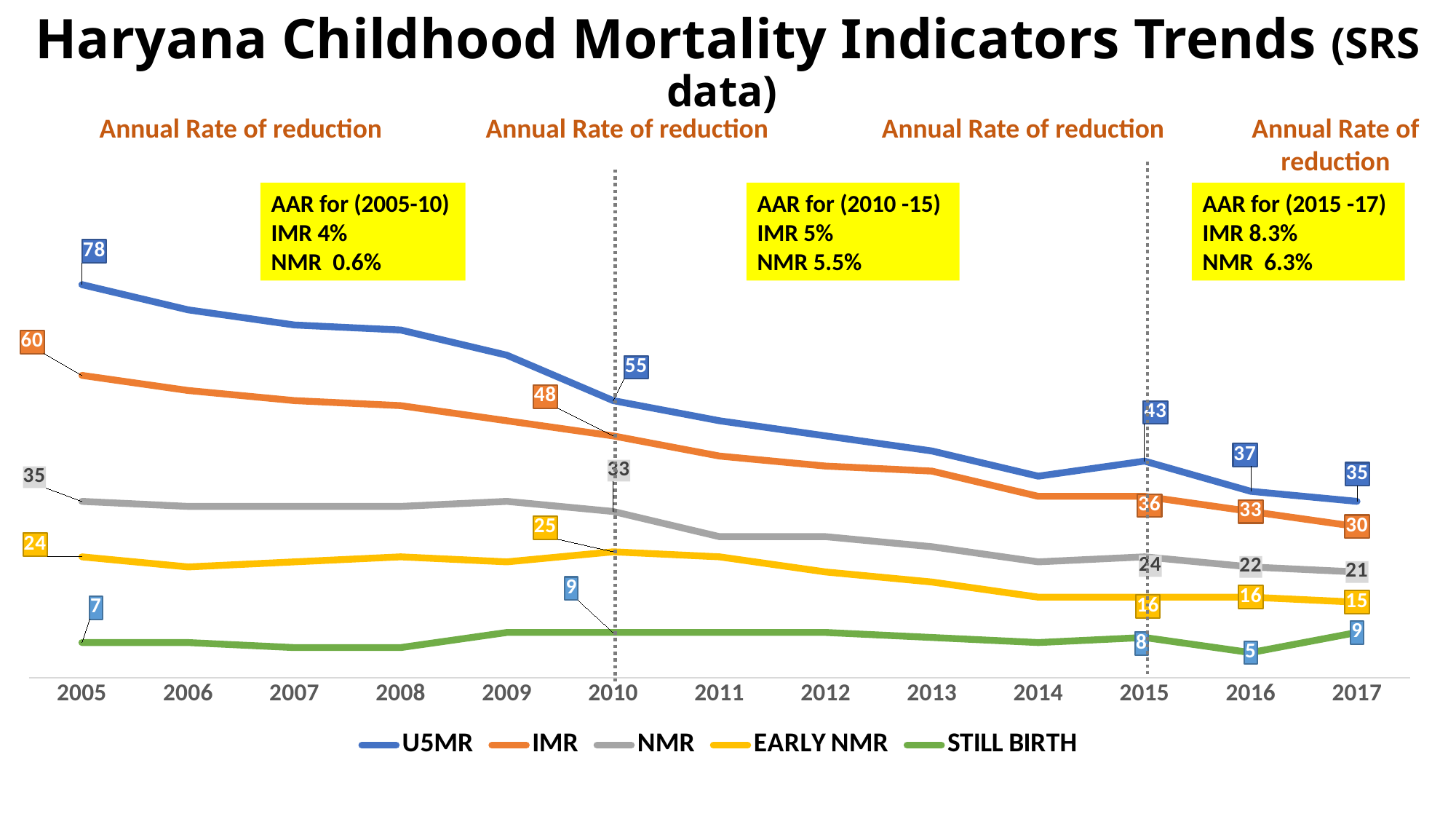
What is the STILL BIRTH value for 2016? 5 How many years are shown on the x axis? 13 What type of chart is shown on the slide? Line chart What is the IMR value for 2017? 30 What is the NMR value for 2010? 33 Does the IMR line rise or fall from 2005 to 2017? Fall By how much did U5MR fall from 2005 to 2017? 43 Which series has the lowest value in 2005? STILL BIRTH What is the EARLY NMR value for 2015? 16 What is the U5MR value for 2005? 78 Which series has the highest value in 2017? U5MR How many series does the legend list? 5